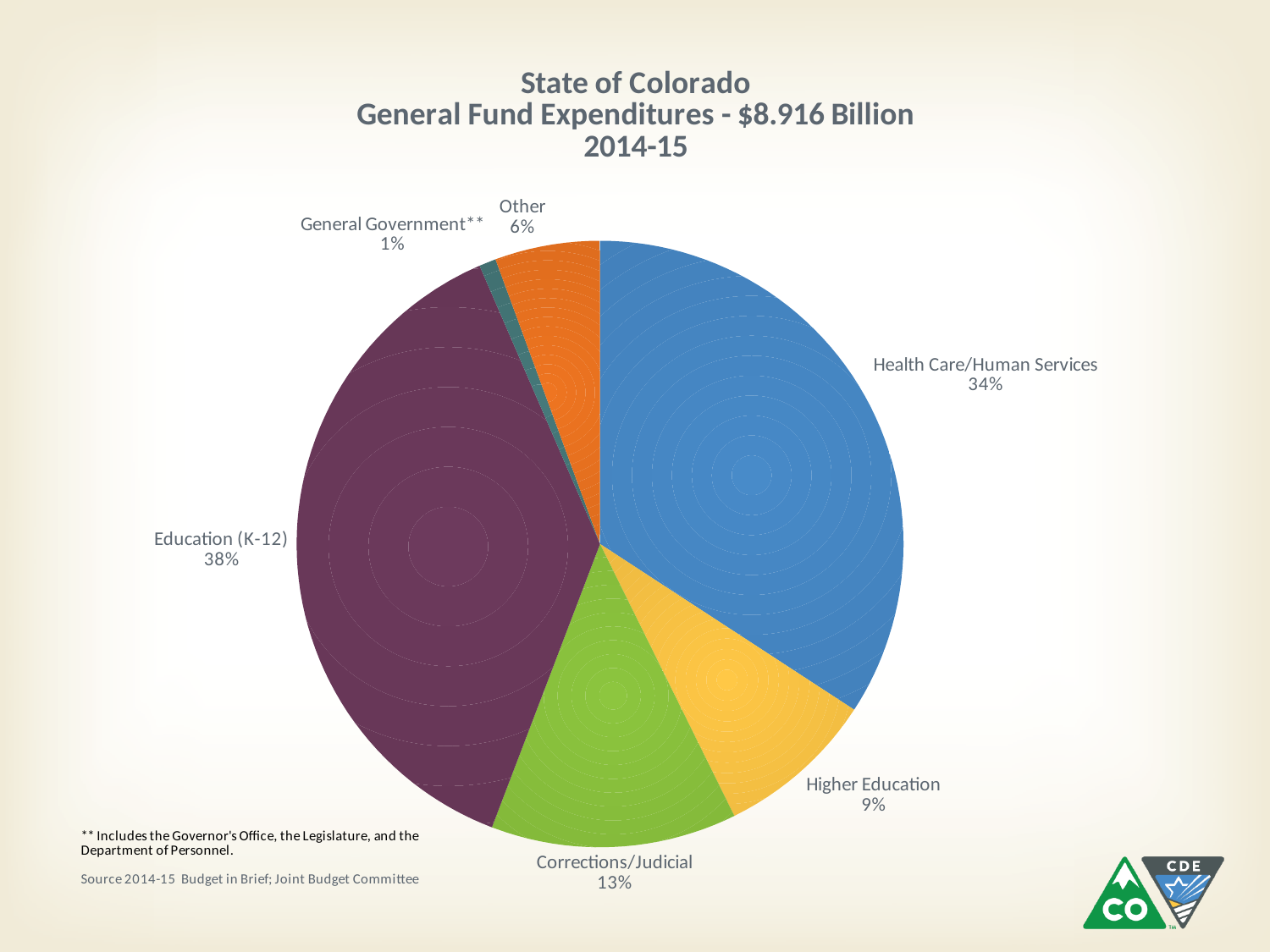
What percentage is shown for Higher Education? 9% What total General Fund expenditure amount is stated in the chart title? $8.916 Billion What is the difference in percentage points between Education (K-12) and Health Care/Human Services? 4 percentage points Which category has the largest share of the pie? Education (K-12) What share of General Fund expenditures goes to Health Care/Human Services? 34% Which category has the smallest share of the pie? General Government** Which is larger, the share for Corrections/Judicial or the share for Higher Education? Corrections/Judicial How many categories are shown in the pie chart? 6 What percentage is shown for Corrections/Judicial? 13% What share of General Fund expenditures goes to Education (K-12)? 38% What percentage is shown for General Government**? 1% What kind of chart is shown on the slide? pie chart